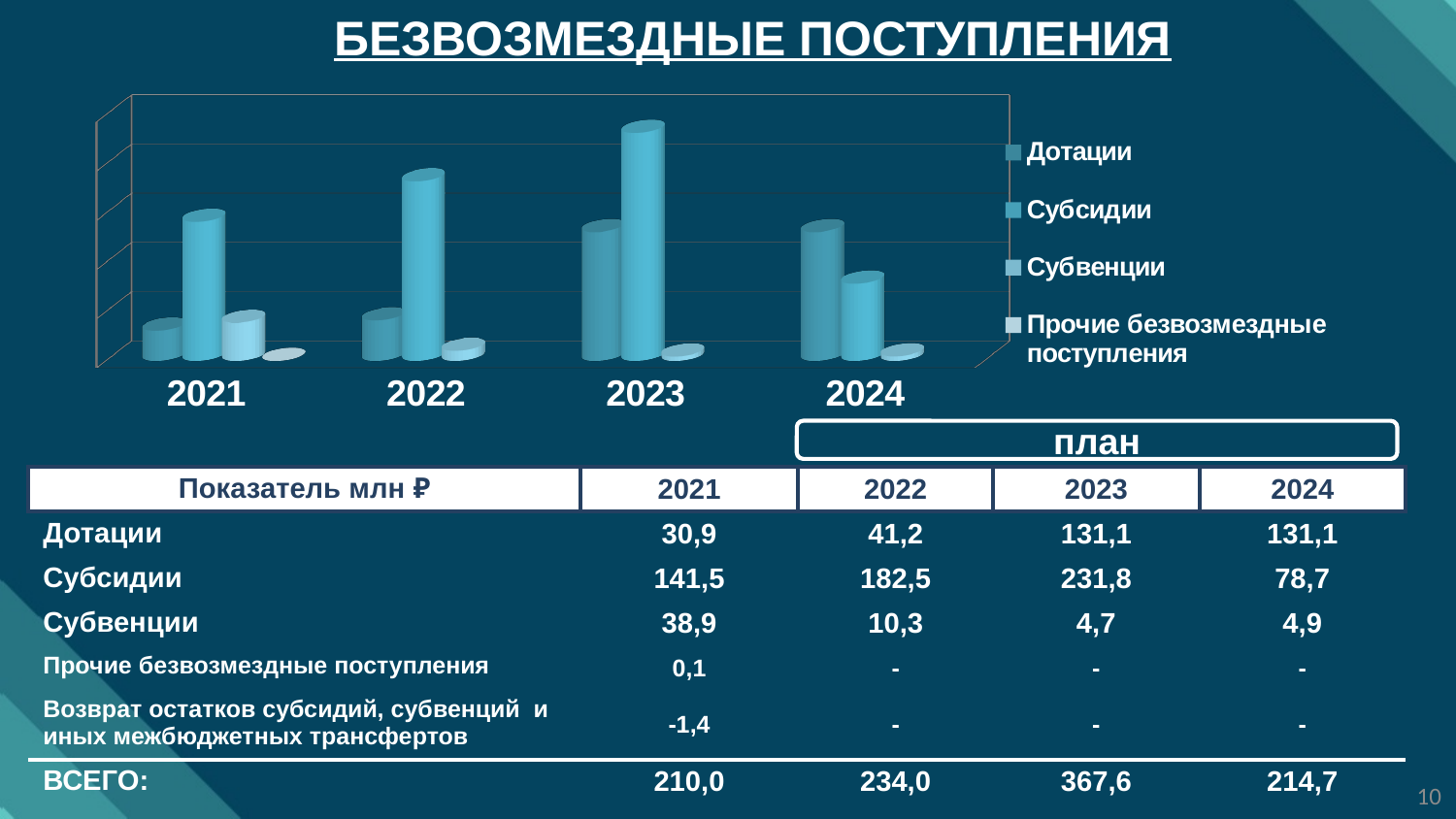
In which year is the Субвенции bar the lowest? 2023 Do the Субвенции values rise or fall from 2021 to 2023? fall What is the last entry listed in the chart legend? Прочие безвозмездные поступления What kind of chart is shown on the slide? bar chart What is the value of Субвенции for 2024? 4,9 What is the value of Дотации for 2021? 30,9 What is the difference between Субсидии in 2023 and Субсидии in 2024? 153,1 How many series does the chart legend list? 4 In which year is the Субсидии bar the highest? 2023 Which is larger in 2024, Дотации or Субсидии? Дотации How many year categories are shown along the x axis of the chart? 4 What is the value of Субсидии for 2023? 231,8